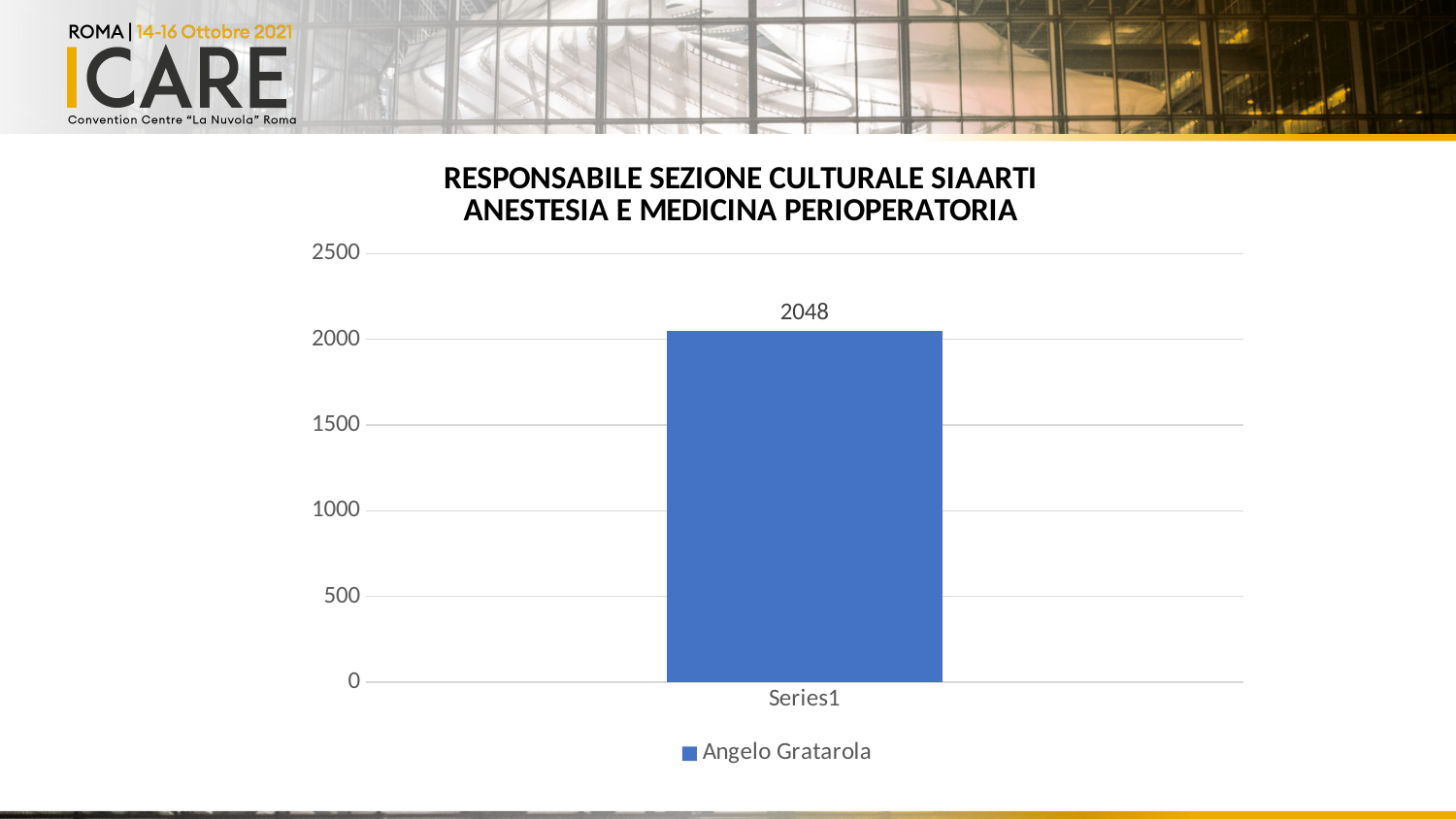
How many series does the legend list? 1 How many bars are plotted in the chart? 1 Is the value for Angelo Gratarola greater or less than 2500? less What is the title of the chart? RESPONSABILE SEZIONE CULTURALE SIAARTI ANESTESIA E MEDICINA PERIOPERATORIA What name appears in the chart legend? Angelo Gratarola What is the highest value shown on the y axis? 2500 What is the label on the x axis under the bar? Series1 Is the value for Angelo Gratarola greater or less than 2000? greater What kind of chart is shown on the slide? bar chart What is the value of the bar for Angelo Gratarola? 2048